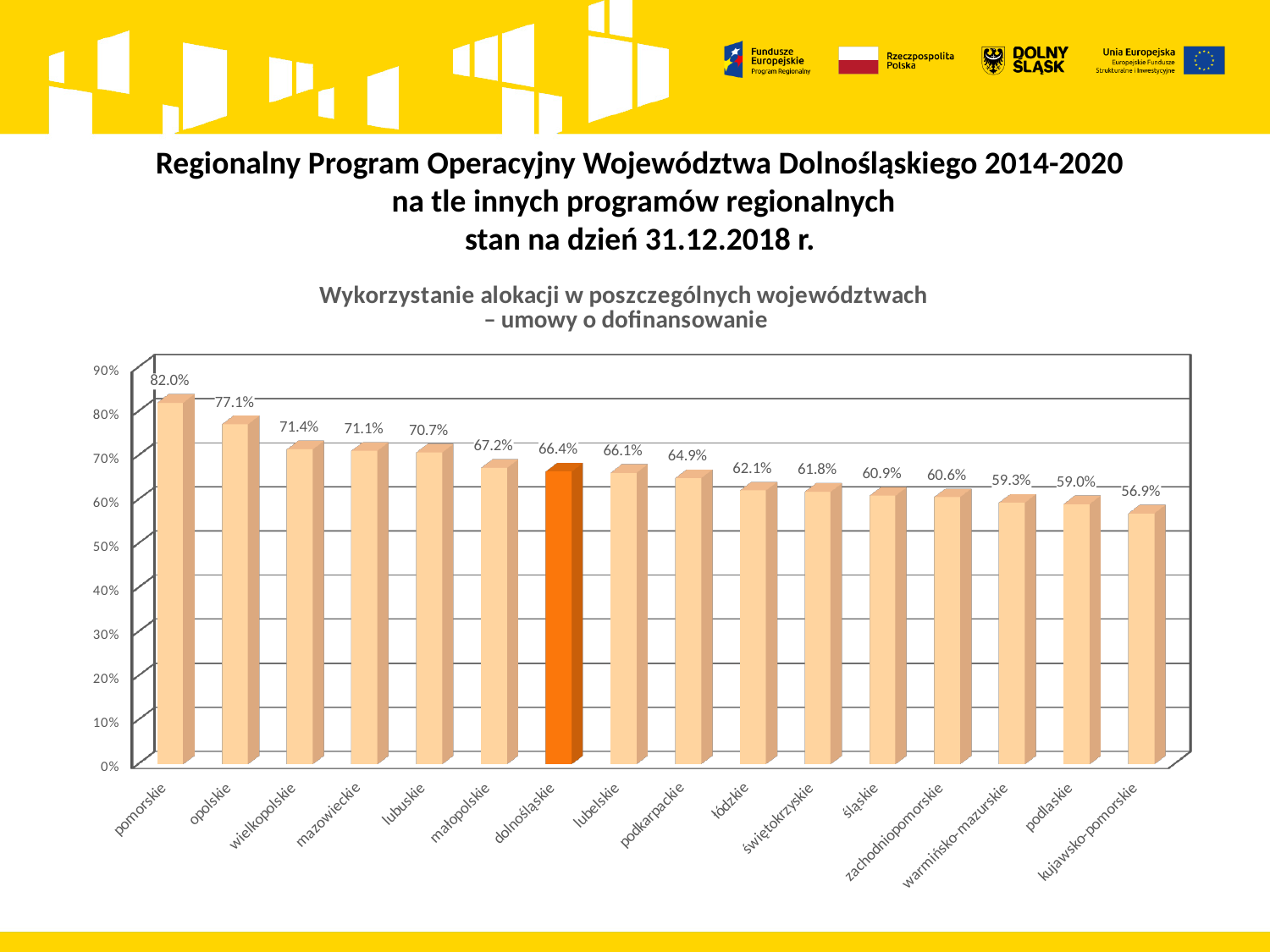
Is the value for podlaskie greater or less than 60%? less Which has a larger value, opolskie or małopolskie? opolskie What is the value for kujawsko-pomorskie? 56.9% Which voivodeship has the highest value? pomorskie What is the difference between the values for pomorskie and dolnośląskie? 15.6% Which bar is highlighted in a different (orange) colour? dolnośląskie What is the value for dolnośląskie? 66.4% What is the value for pomorskie? 82.0% Which voivodeship has the lowest value? kujawsko-pomorskie What is the value for lubuskie? 70.7% What kind of chart is shown on the slide? bar chart How many voivodeships are shown on the chart? 16